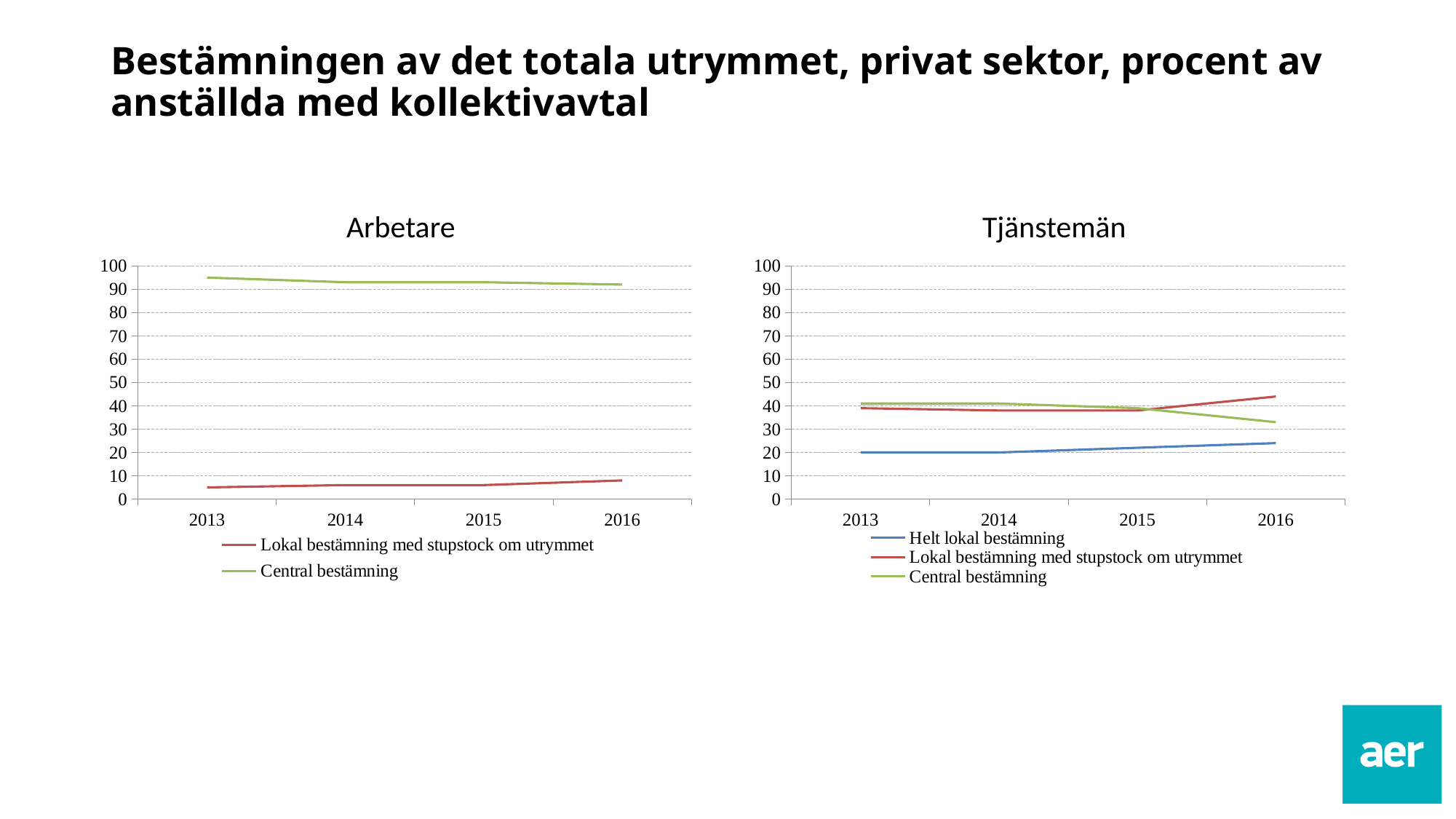
How many series does the legend of the Tjänstemän chart list? 3 How many series does the legend of the Arbetare chart list? 2 In the Arbetare chart, is the value for Central bestämning in 2013 greater or less than 90? greater In the Arbetare chart, which series has the higher value in 2016, Central bestämning or Lokal bestämning med stupstock om utrymmet? Central bestämning How many years are shown on the x axis of the Arbetare chart? 4 In the Tjänstemän chart, does the Central bestämning line rise or fall from 2013 to 2016? fall In the Arbetare chart, does the Central bestämning line rise or fall from 2013 to 2016? fall In the Arbetare chart, is the value for Lokal bestämning med stupstock om utrymmet in 2016 greater or less than 10? less What kind of chart is the Arbetare chart? line chart In the Tjänstemän chart, does the Helt lokal bestämning line rise or fall from 2013 to 2016? rise What is the title of the chart on the right side of the slide? Tjänstemän In the Tjänstemän chart, is the value for Helt lokal bestämning in 2013 greater or less than 30? less